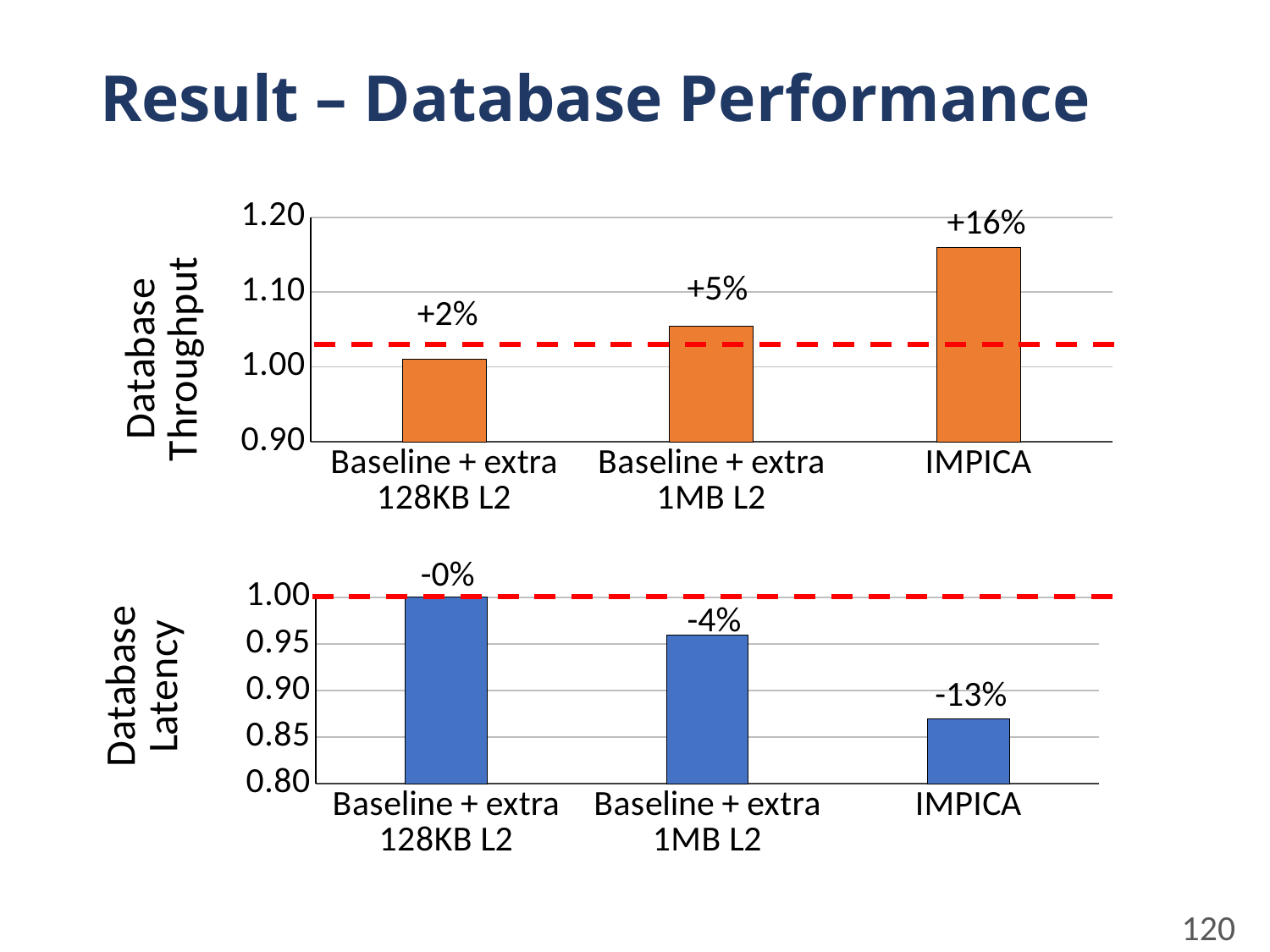
What colour are the bars in the Database Throughput chart? Orange In the Database Latency chart, what is the data label on the IMPICA bar? -13% In the Database Throughput chart, which category has the highest bar? IMPICA How many categories are shown in the Database Latency chart? 3 In the Database Latency chart, what is the data label on the Baseline + extra 128KB L2 bar? -0% In the Database Throughput chart, what is the data label on the IMPICA bar? +16% In the Database Latency chart, is the value for IMPICA greater or less than 0.90? less In the Database Throughput chart, is the value for IMPICA greater or less than 1.10? greater In the Database Throughput chart, what is the data label on the Baseline + extra 1MB L2 bar? +5% In the Database Latency chart, which category has the lowest bar? IMPICA Do the bar values in the Database Latency chart rise or fall from left to right? fall In the Database Throughput chart, which bar is taller: Baseline + extra 128KB L2 or Baseline + extra 1MB L2? Baseline + extra 1MB L2